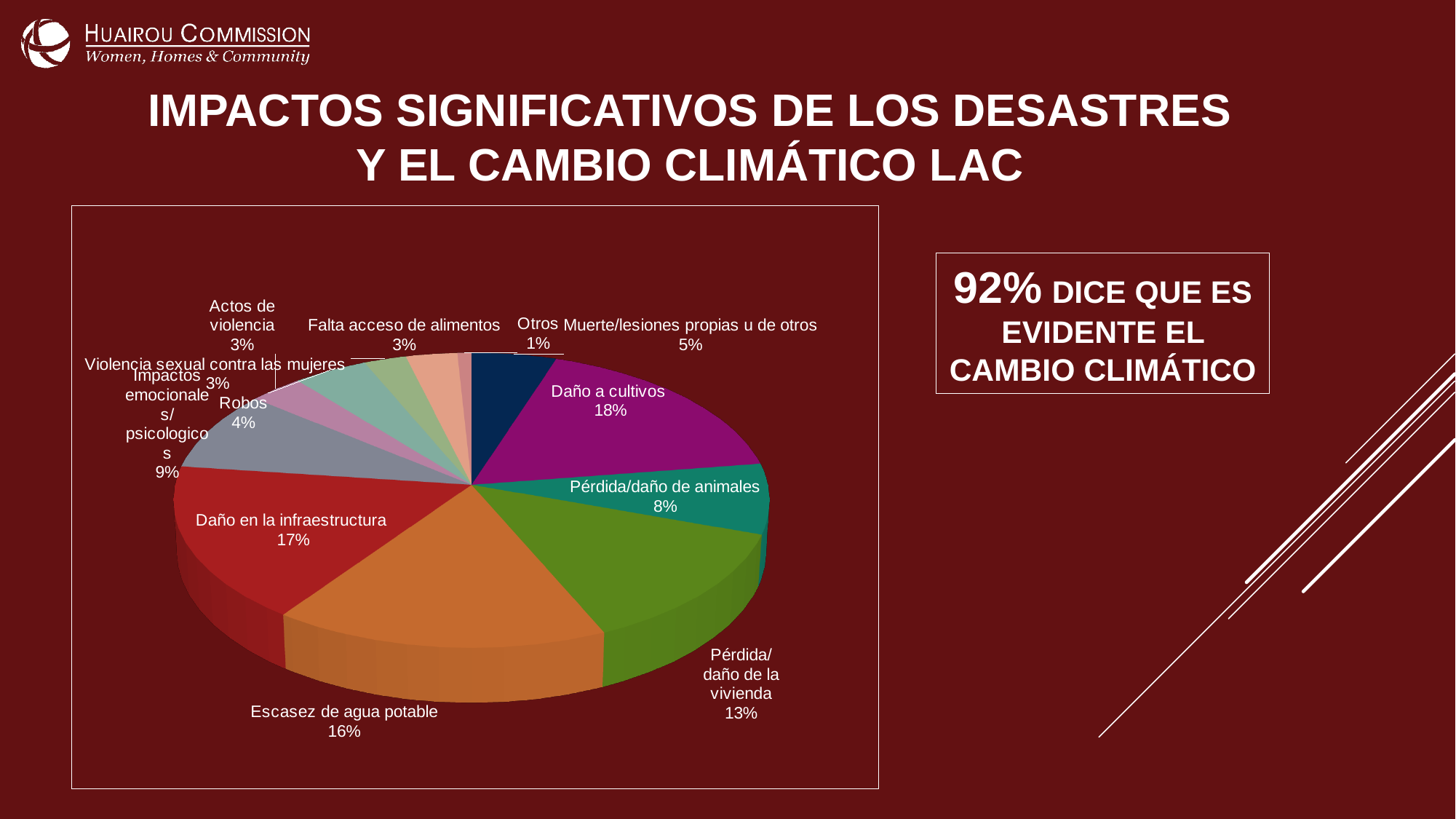
Which category has the largest share of the pie? Daño a cultivos Which is larger, the share for "Muerte/lesiones propias u de otros" or the share for "Pérdida/daño de animales"? Pérdida/daño de animales What percentage is shown for "Robos"? 4% What percentage is shown for "Pérdida/daño de la vivienda"? 13% Which category has the smallest share of the pie? Otros What share of the pie is labelled for "Daño a cultivos"? 18% What is the difference in percentage points between "Daño en la infraestructura" and "Pérdida/daño de animales"? 9 What kind of chart is shown on the slide? Pie chart What percentage is shown for "Impactos emocionales/psicologicos"? 9% How many categories (slices) does the pie chart have? 12 What percentage is shown for "Escasez de agua potable"? 16% What percentage does the text box to the right of the chart say find climate change evident? 92%